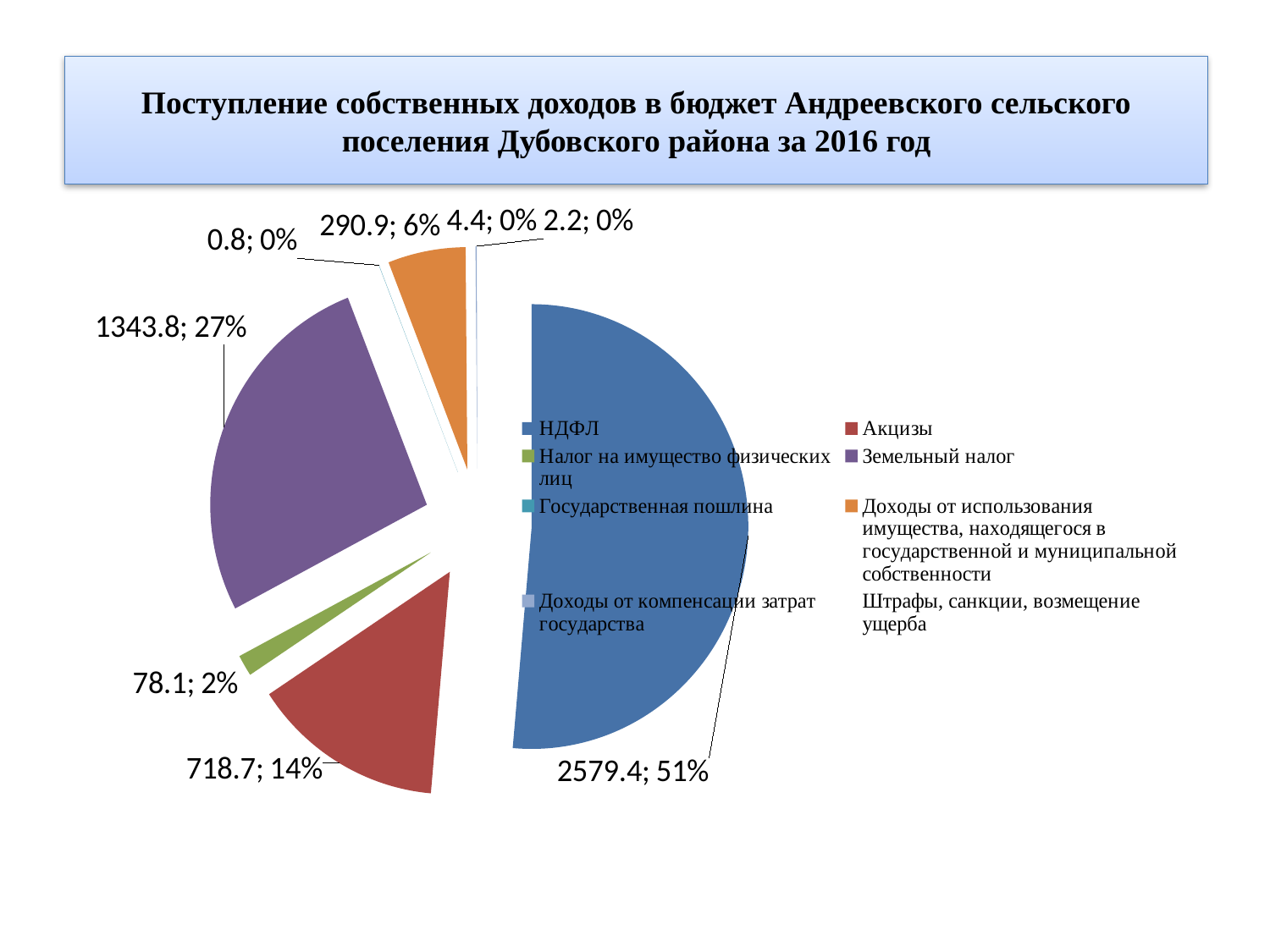
Which is larger, the value for Акцизы or the value for Земельный налог? Земельный налог What share of the pie does НДФЛ represent? 51% What is the value shown for Земельный налог? 1343.8 What share of the pie does Земельный налог represent? 27% What share of the pie does Налог на имущество физических лиц represent? 2% What is the value shown for НДФЛ? 2579.4 What is the difference between the values for НДФЛ and Земельный налог? 1235.6 What is the value shown for Акцизы? 718.7 Which category has the largest slice of the pie? НДФЛ How many categories does the legend list? 8 What kind of chart is shown on the slide? pie chart What is the value shown for Доходы от использования имущества, находящегося в государственной и муниципальной собственности? 290.9